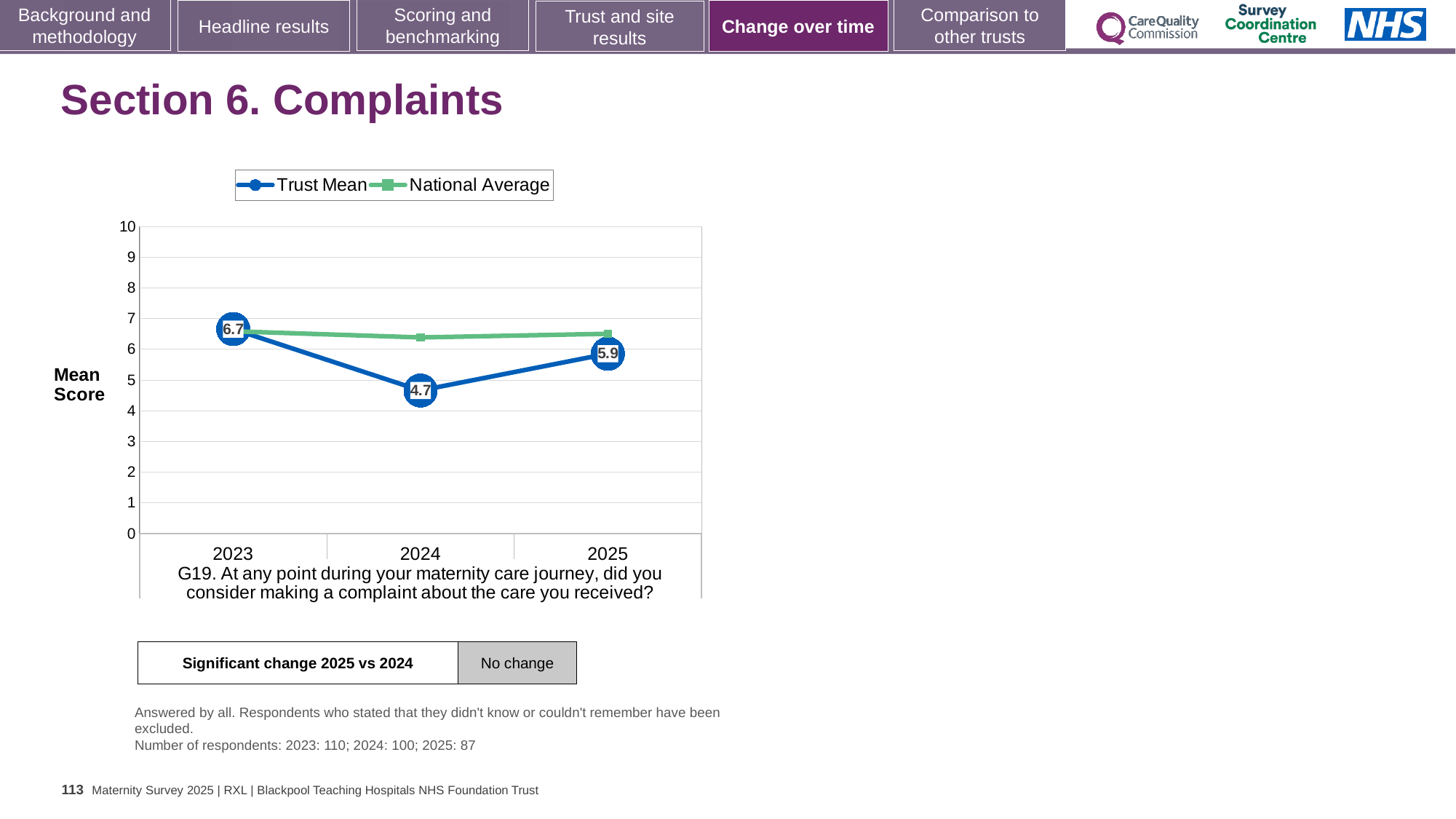
Is the National Average value for 2024 greater or less than 6? greater What is the Trust Mean score for 2025? 5.9 In 2024, which is higher: the Trust Mean or the National Average? National Average What is the Trust Mean score for 2023? 6.7 In which year is the Trust Mean score lowest? 2024 Does the Trust Mean rise or fall from 2023 to 2024? Fall What is the Trust Mean score for 2024? 4.7 What kind of chart is shown on the slide? Line chart How many years are shown on the x axis of the chart? 3 What is the difference between the Trust Mean scores for 2023 and 2024? 2.0 How many series does the chart legend list? 2 In which year is the Trust Mean score highest? 2023